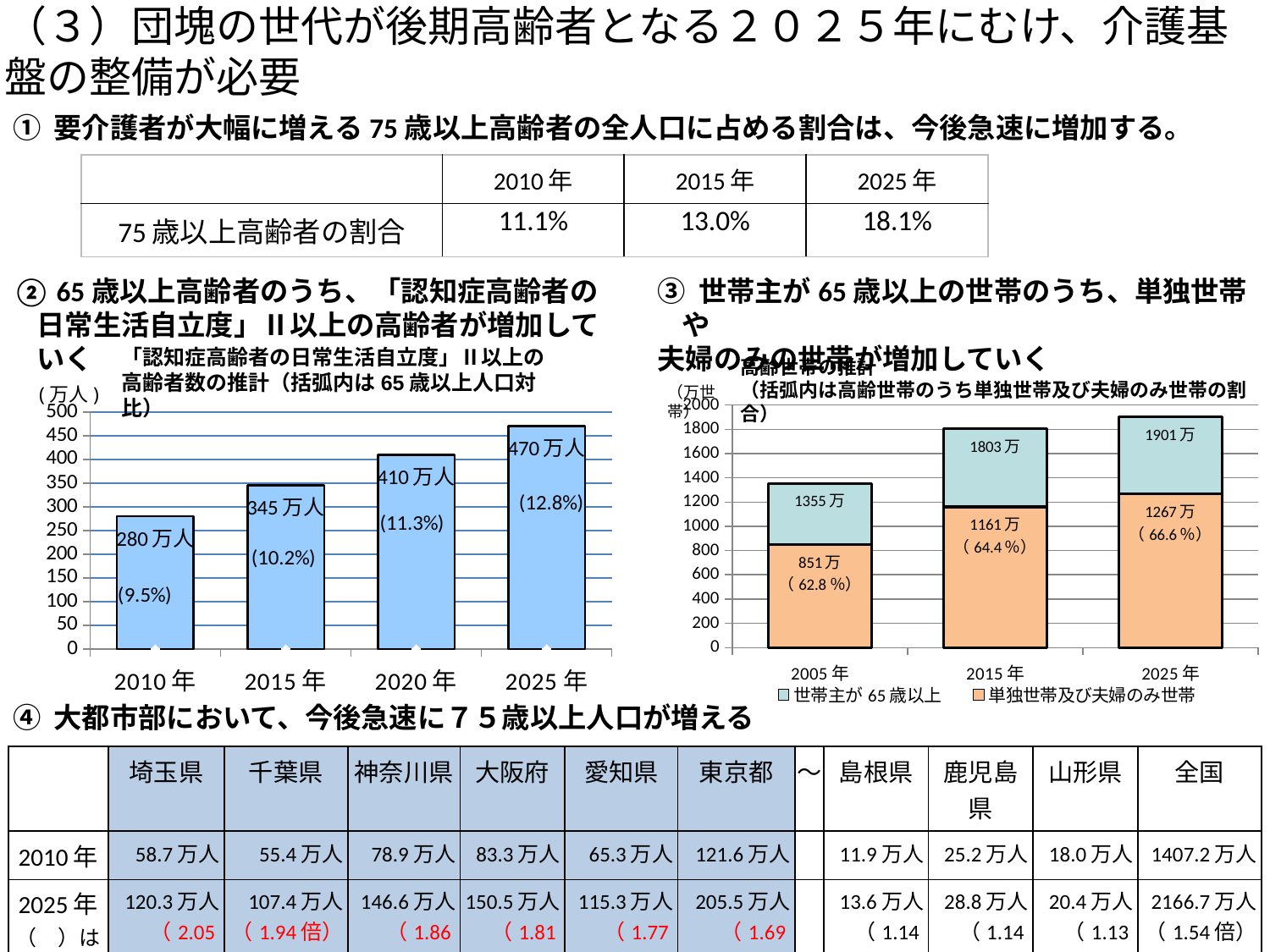
In the right chart (高齢世帯の推計), what is the value for 単独世帯及び夫婦のみ世帯 in 2015年? 1161万 In the right chart, how many series does the legend list? 2 In the left chart, do the values rise or fall from 2010年 to 2025年? rise What type of chart is the left chart? bar chart In the right chart, what is the value labelled for 世帯主が65歳以上 in 2025年? 1901万 In the left chart, what is the difference between the values for 2025年 and 2015年? 125万人 In the left chart (認知症高齢者の日常生活自立度 Ⅱ以上の高齢者数の推計), what is the value for 2010年? 280万人 In the right chart, which is larger: the 単独世帯及び夫婦のみ世帯 value for 2005年 or for 2025年? 2025年 In the left chart, what is the value for 2025年? 470万人 In the left chart, what percentage is shown in parentheses for 2020年? 11.3% In the left chart, which year has the lowest value? 2010年 In the left chart, how many years are plotted? 4